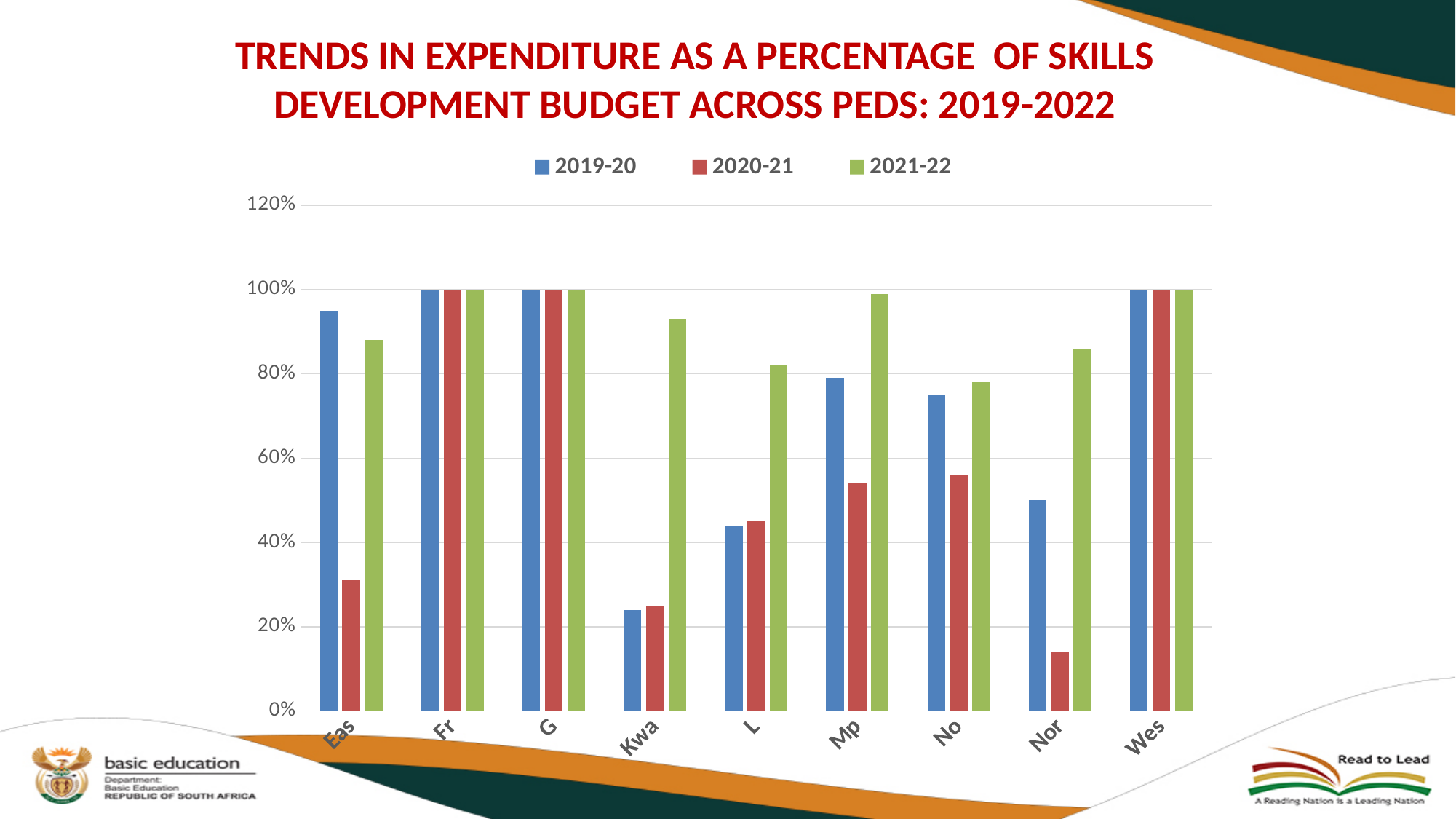
Is the 2020-21 value for Eas greater or less than 40%? less Is the 2020-21 value for Nor greater or less than 20%? less What is the 2019-20 value for Fr? 100% Which category has the lowest 2020-21 value? Nor For Eas, which is larger: the 2019-20 value or the 2020-21 value? 2019-20 Which category has the lowest 2019-20 value? Kwa What kind of chart is shown on the slide? Bar chart What is the 2021-22 value for Wes? 100% How many categories are shown along the x axis? 9 Which colour represents the 2021-22 series in the legend? Green How many series does the legend list? 3 Is the 2021-22 value for Mp greater or less than 80%? greater